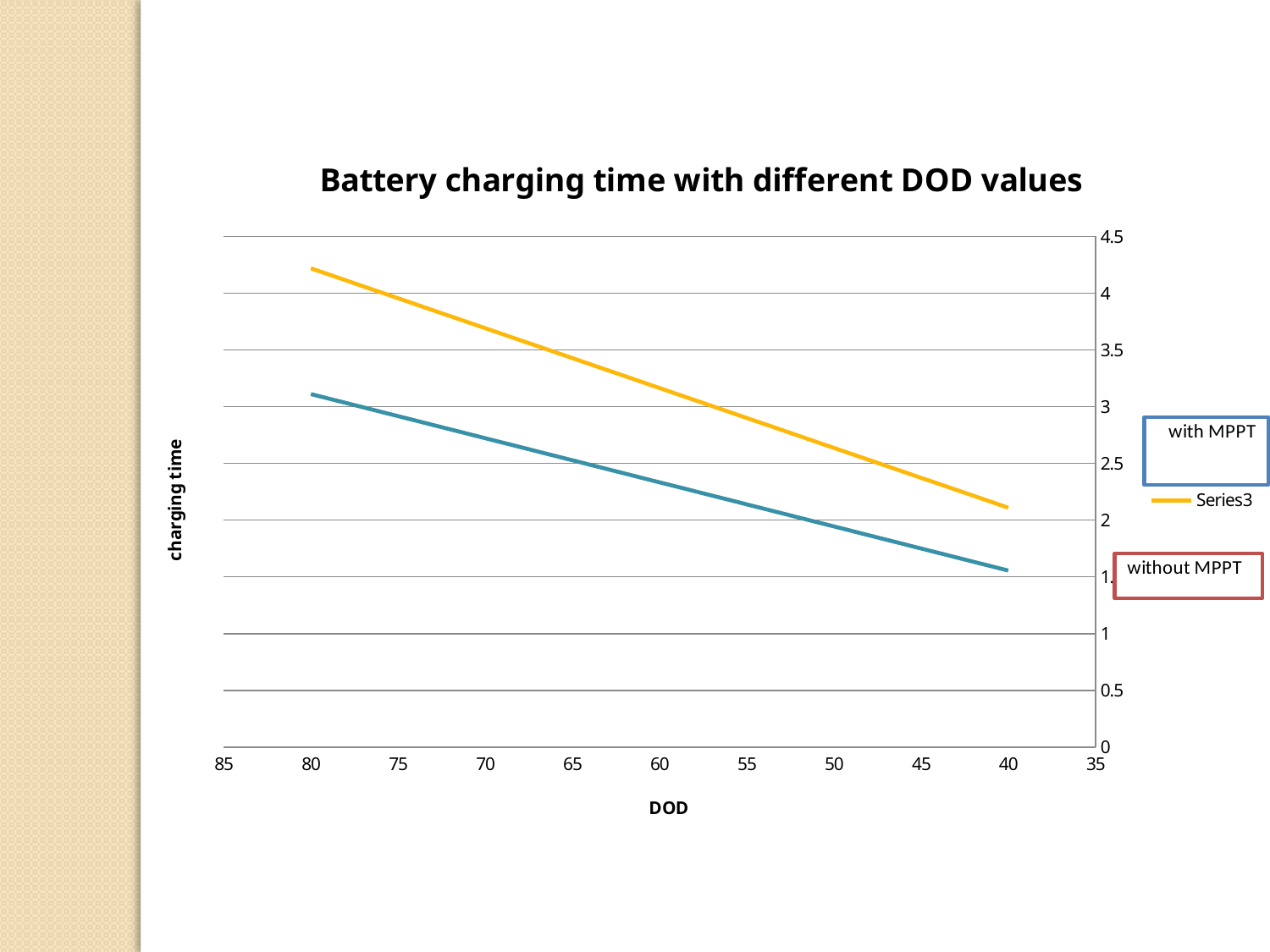
Is the value of the blue line at DOD 40 greater or less than 2? less What series name is shown in the chart legend? Series3 Is the value of the blue line at DOD 60 greater or less than 2.5? less What type of chart is shown on the slide? line chart What is the title of the chart? Battery charging time with different DOD values Which line is higher at DOD 80, the orange line or the blue line? orange line What is the label of the x axis? DOD Is the value of the orange line at DOD 80 greater or less than 4? greater Do the plotted lines rise or fall from left to right along the DOD axis? fall How many lines are plotted on the chart? 2